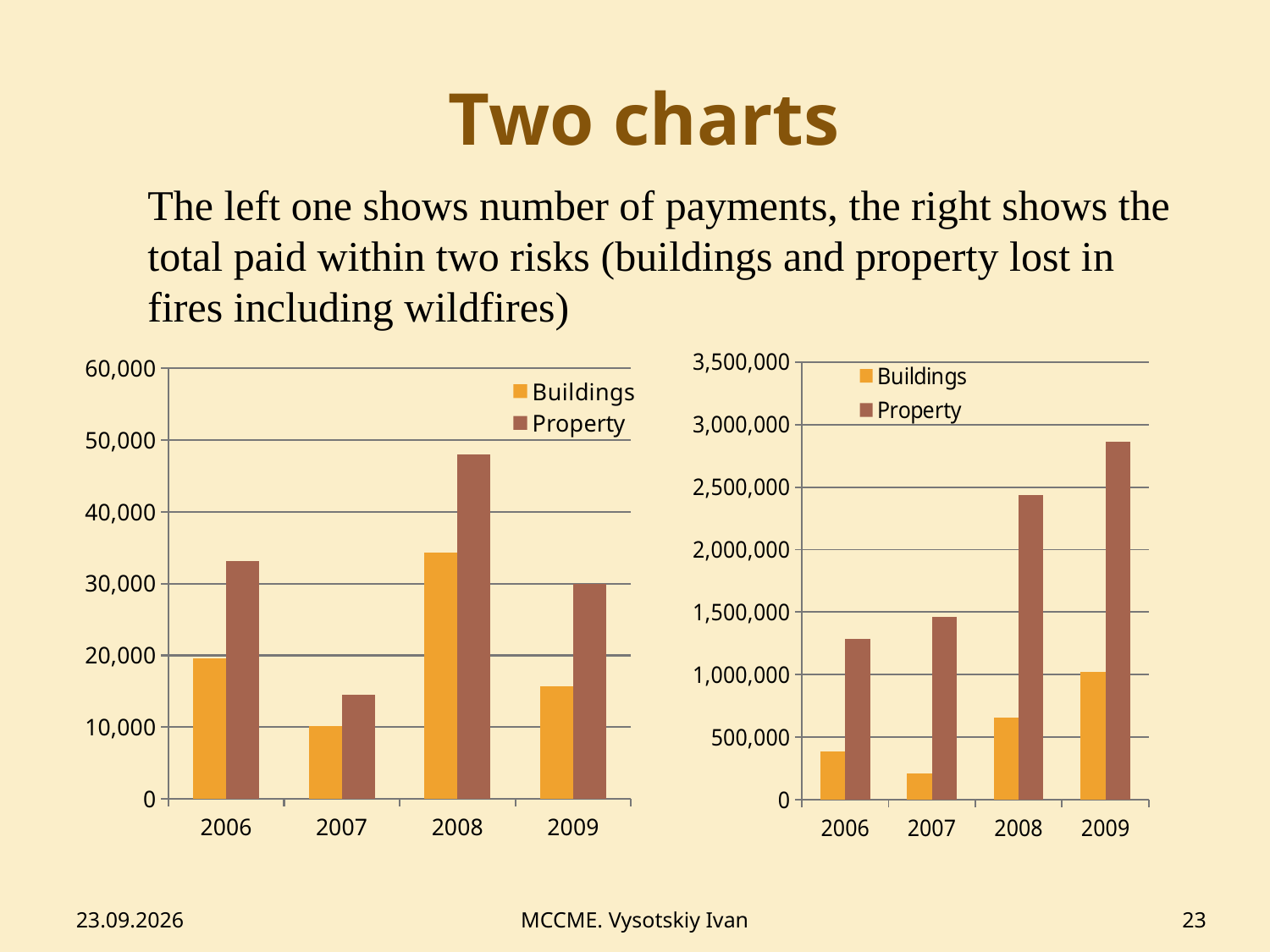
What kind of chart is the left chart (number of payments)? bar chart In the right chart (total paid), is the Buildings value for 2006 greater or less than 500,000? less In the right chart (total paid), which year has the highest Property bar? 2009 In the right chart (total paid), is the Property value for 2008 greater or less than 2,000,000? greater In the left chart (number of payments), which is larger for 2009: Buildings or Property? Property In the left chart (number of payments), which year has the lowest Buildings bar? 2007 In the left chart (number of payments), is the Property value for 2008 greater or less than 40,000? greater In the right chart (total paid), do the Property values rise or fall from 2006 to 2009? rise In the left chart (number of payments), which year has the highest Property bar? 2008 In the right chart (total paid), which year has the lowest Buildings bar? 2007 How many years are shown on the x axis of the left chart (number of payments)? 4 How many series does the legend of the right chart (total paid) list? 2